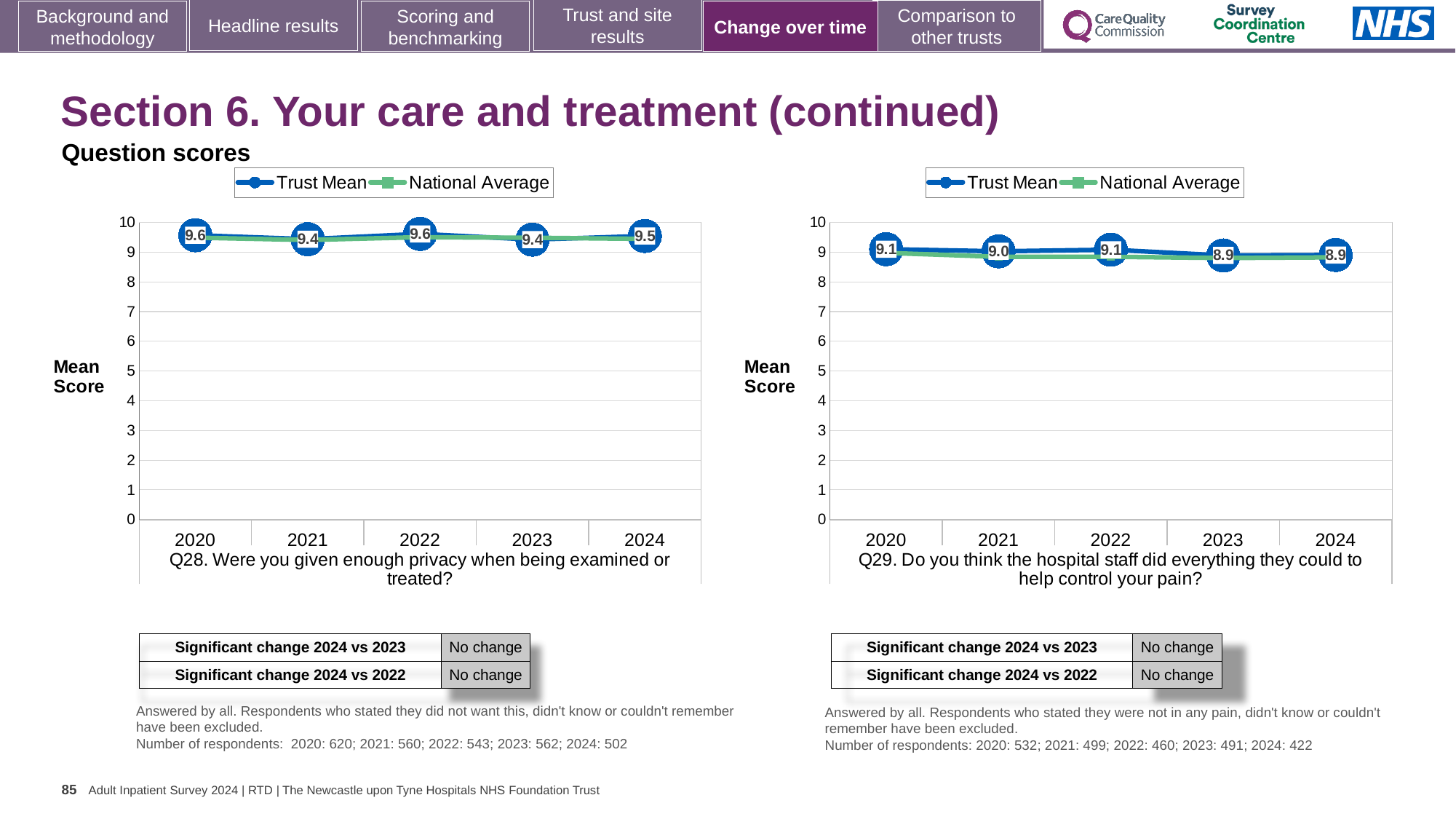
On the Q28 chart (left), what is the Trust Mean score for 2024? 9.5 On the Q29 chart (right), is the National Average value for 2024 greater or less than 8? greater On the Q29 chart (right), does the Trust Mean score rise or fall from 2020 to 2024? Fall On the Q28 chart (left), what is the Trust Mean score for 2020? 9.6 On the Q28 chart (left), what is the difference between the Trust Mean scores for 2020 and 2021? 0.2 How many series does the legend of the Q29 chart (right) list? 2 On the Q28 chart (left), which year has the larger Trust Mean score, 2022 or 2023? 2022 On the Q29 chart (right), what is the Trust Mean score for 2021? 9.0 How many years are plotted on the Q28 chart (left)? 5 On the Q29 chart (right), what is the Trust Mean score for 2023? 8.9 What kind of chart is the Q28 chart (left)? Line chart On the Q29 chart (right), what is the difference between the Trust Mean scores for 2020 and 2024? 0.2